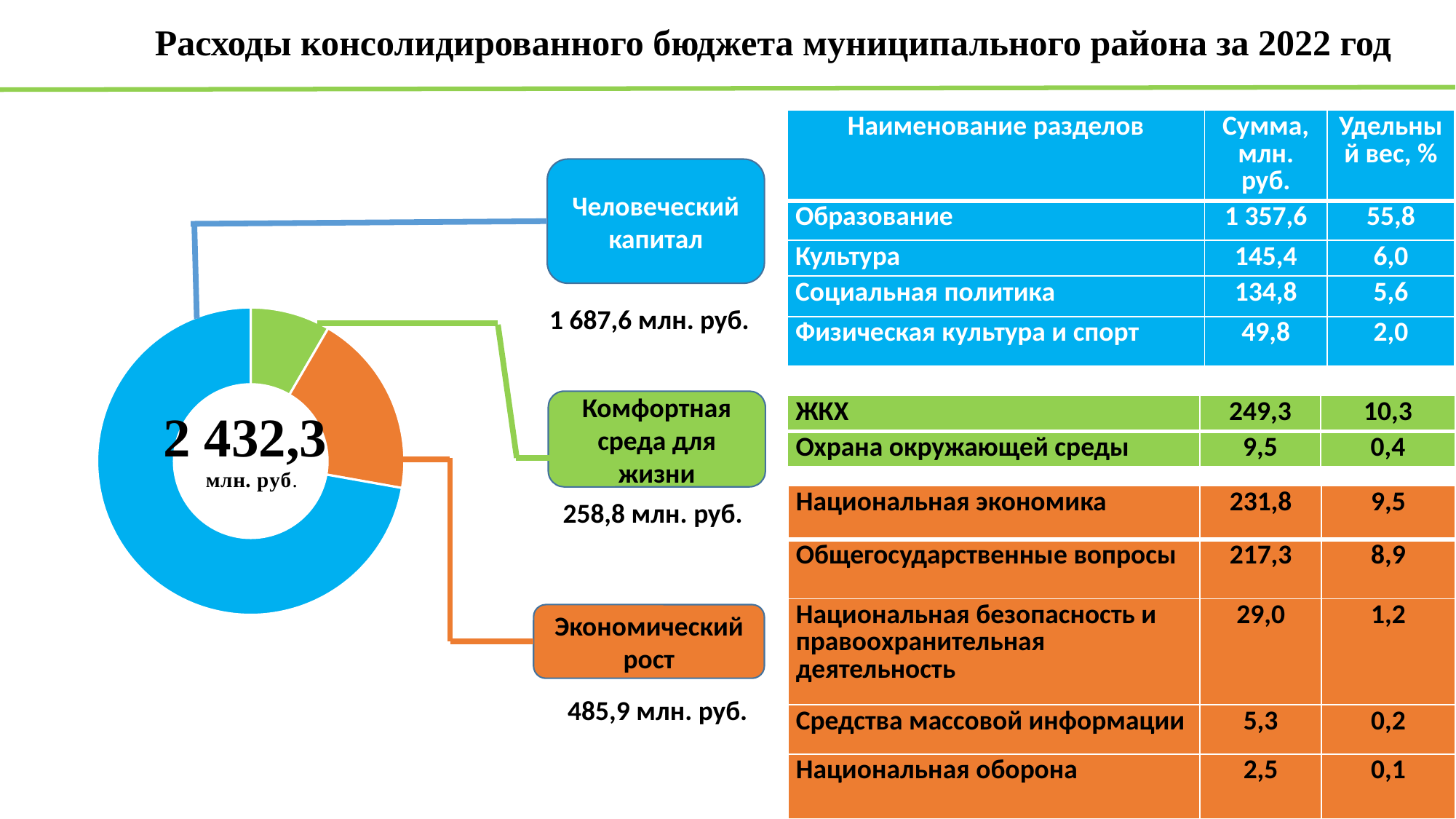
What is the total value shown in the centre of the donut chart? 2 432,3 млн. руб. What kind of chart is shown on the left of the slide? Donut (pie) chart What is the difference between Человеческий капитал and Экономический рост? 1 201,7 млн. руб. How many segments does the donut chart have? 3 What is the difference between Экономический рост and Комфортная среда для жизни? 227,1 млн. руб. What is the value shown for Экономический рост? 485,9 млн. руб. What is the value shown for Комфортная среда для жизни? 258,8 млн. руб. Which segment of the donut chart is the largest? Человеческий капитал Which is larger, Экономический рост or Комфортная среда для жизни? Экономический рост What is the value shown for Человеческий капитал? 1 687,6 млн. руб. What colour is the Экономический рост segment of the donut chart? Orange Which segment of the donut chart is the smallest? Комфортная среда для жизни